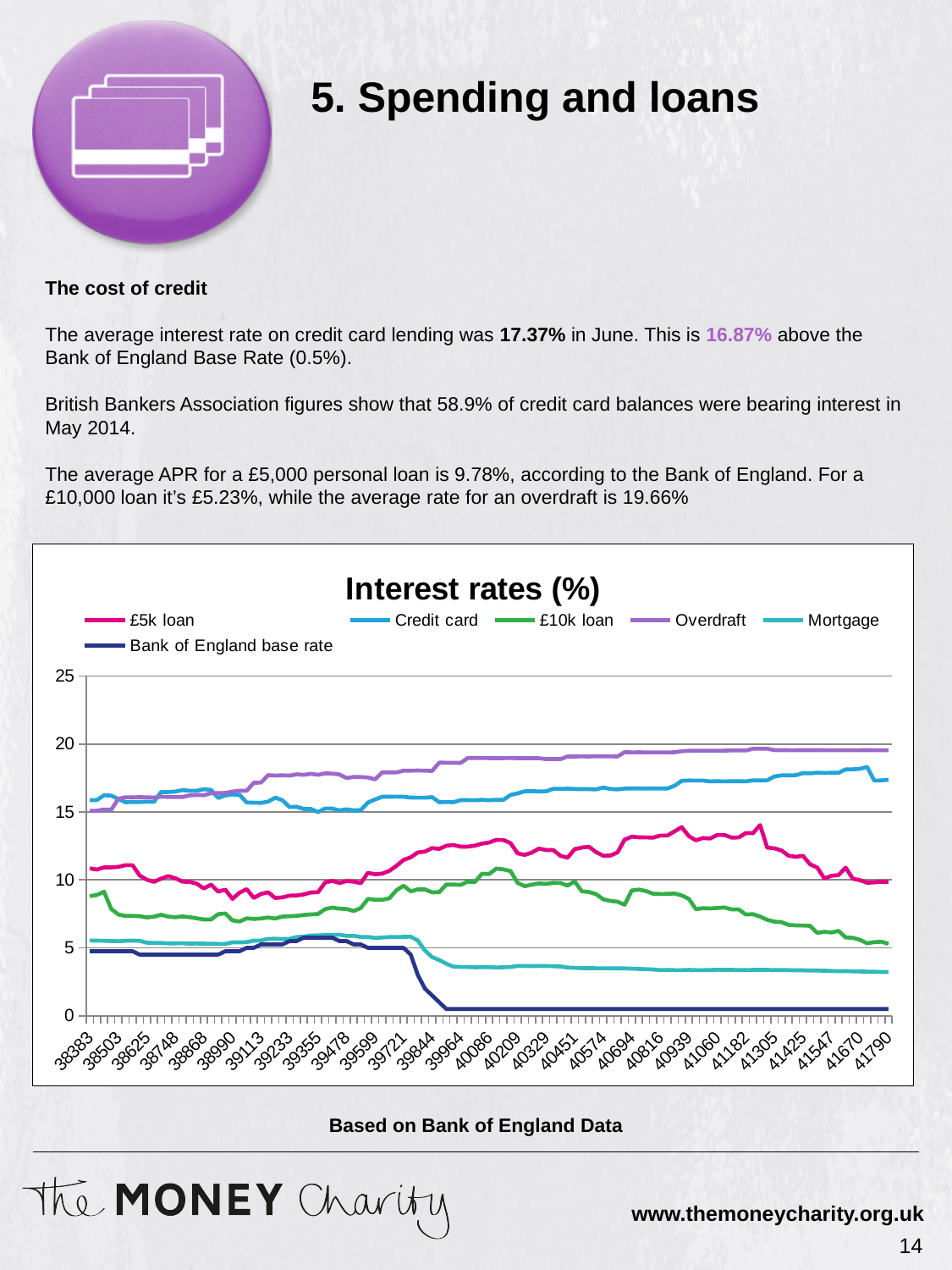
Which series is highest at the right-hand end of the chart? Overdraft What kind of chart is shown on the slide? Line chart Does the Overdraft series rise or fall overall from left to right? Rise Is the value for £5k loan at the right-hand end of the chart greater or less than 15? less Which series is lowest at the right-hand end of the chart? Bank of England base rate Is the value for Mortgage at the right-hand end of the chart greater or less than 5? less Does the Bank of England base rate series rise or fall overall from left to right? Fall How many series does the chart legend list? 6 At the right-hand end of the chart, which is larger: Credit card or £10k loan? Credit card What is the title of the chart? Interest rates (%) Is the value for Overdraft at the right-hand end of the chart greater or less than 15? greater